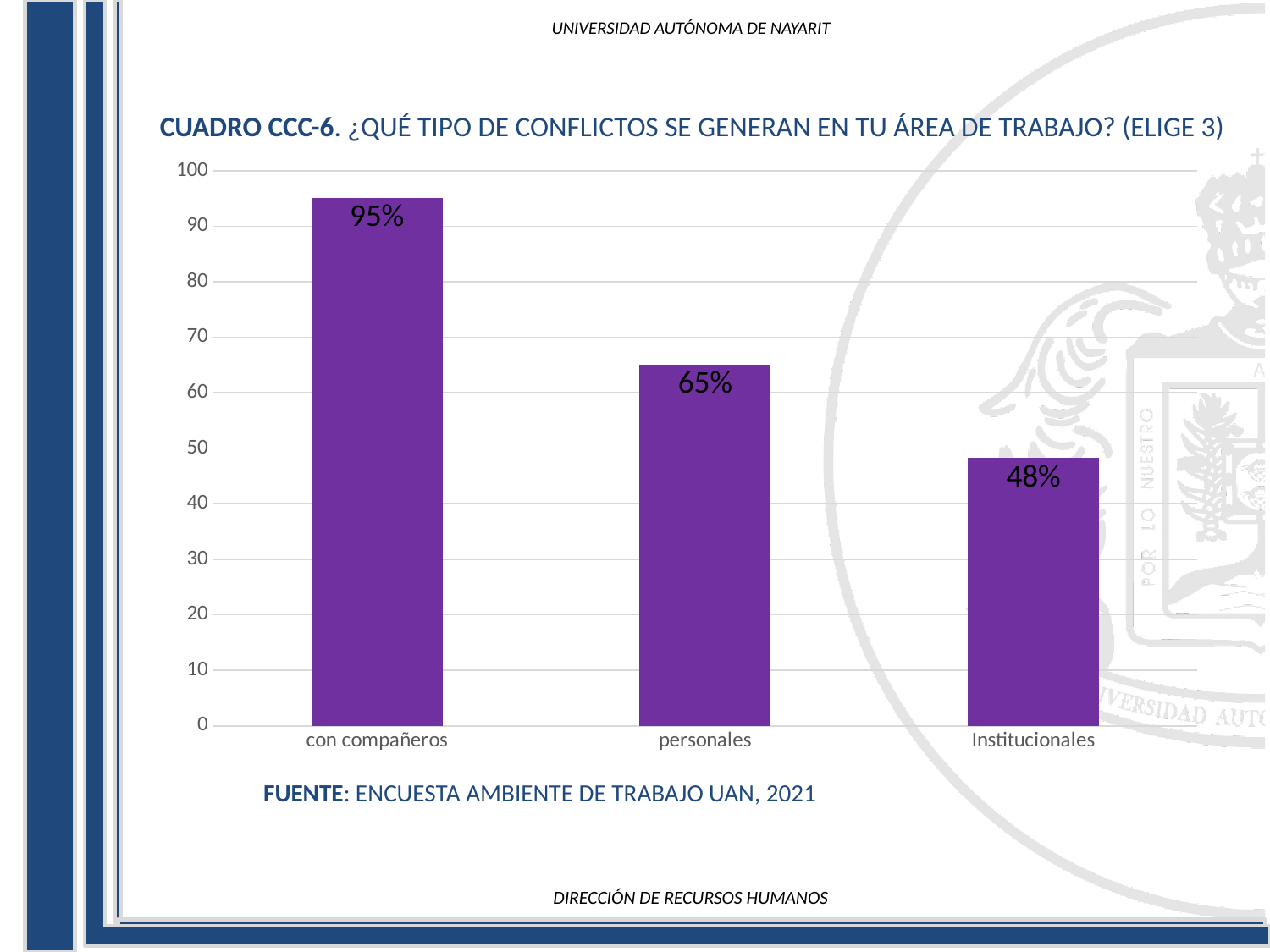
Which category has the highest value? con compañeros What is the value for Institucionales? 48% How many categories are shown in the chart? 3 What kind of chart is shown on the slide? bar chart What is the value for personales? 65% Do the values rise or fall from left to right along the x axis? fall Is the value for Institucionales greater or less than 50? less Which is larger, the value for personales or the value for Institucionales? personales Which category has the lowest value? Institucionales What is the difference between the values for con compañeros and personales? 30% What is the difference between the values for personales and Institucionales? 17% What is the value for con compañeros? 95%